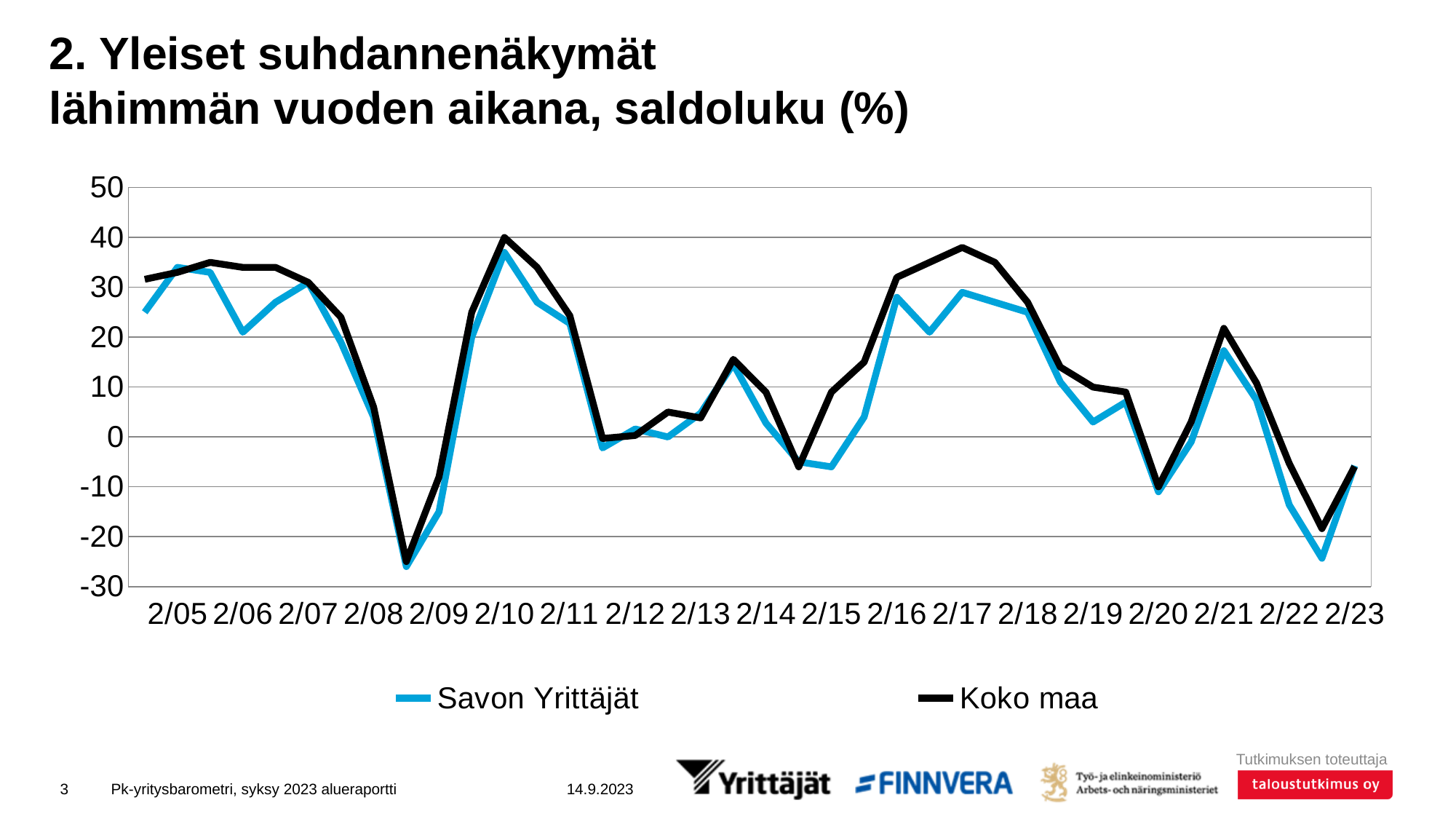
Is the value for Savon Yrittäjät at 2/19 greater or less than 10? less At 2/06, which series has the higher value, Savon Yrittäjät or Koko maa? Koko maa How many labels are shown on the x axis? 19 Is the value for Koko maa at 2/10 greater or less than 30? greater What kind of chart is shown on the slide? line chart How many series does the legend list? 2 At which x-axis label does Savon Yrittäjät reach its highest value? 2/10 Is the value for Koko maa at 2/17 greater or less than 30? greater At 2/21, which series has the higher value, Savon Yrittäjät or Koko maa? Koko maa Does the Koko maa line rise or fall from 2/17 to 2/20? fall